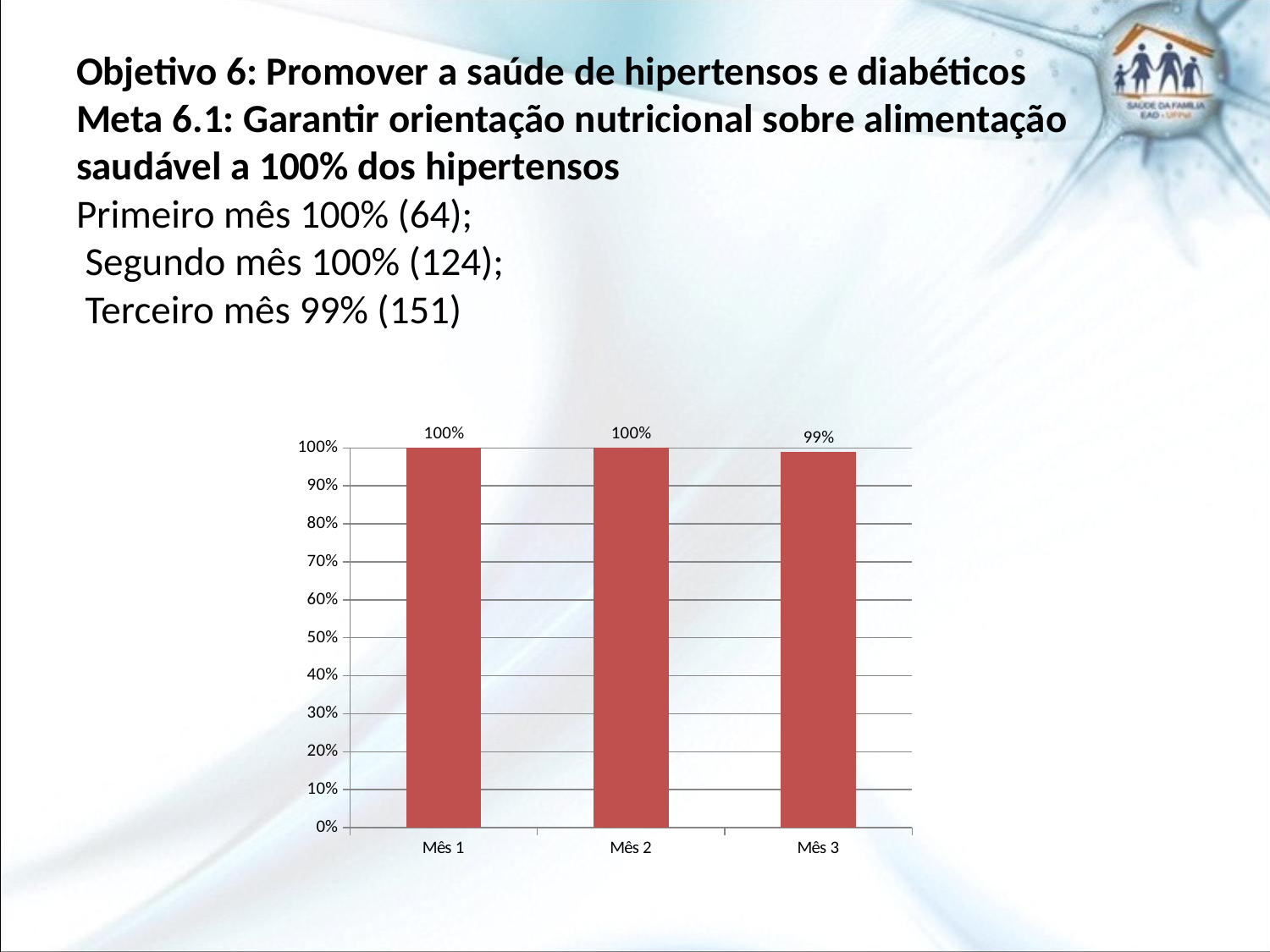
Do the values rise or fall from Mês 2 to Mês 3? Fall Which month has the lowest value? Mês 3 Is the value for Mês 2 greater or less than 50%? greater How many categories are shown on the x axis? 3 What is the difference between the values for Mês 1 and Mês 3? 1% What is the value for Mês 3? 99% What colour are the bars in the chart? Red What is the value for Mês 1? 100% What kind of chart is shown on the slide? Bar chart What is the highest value shown on the y axis? 100% What is the value for Mês 2? 100%